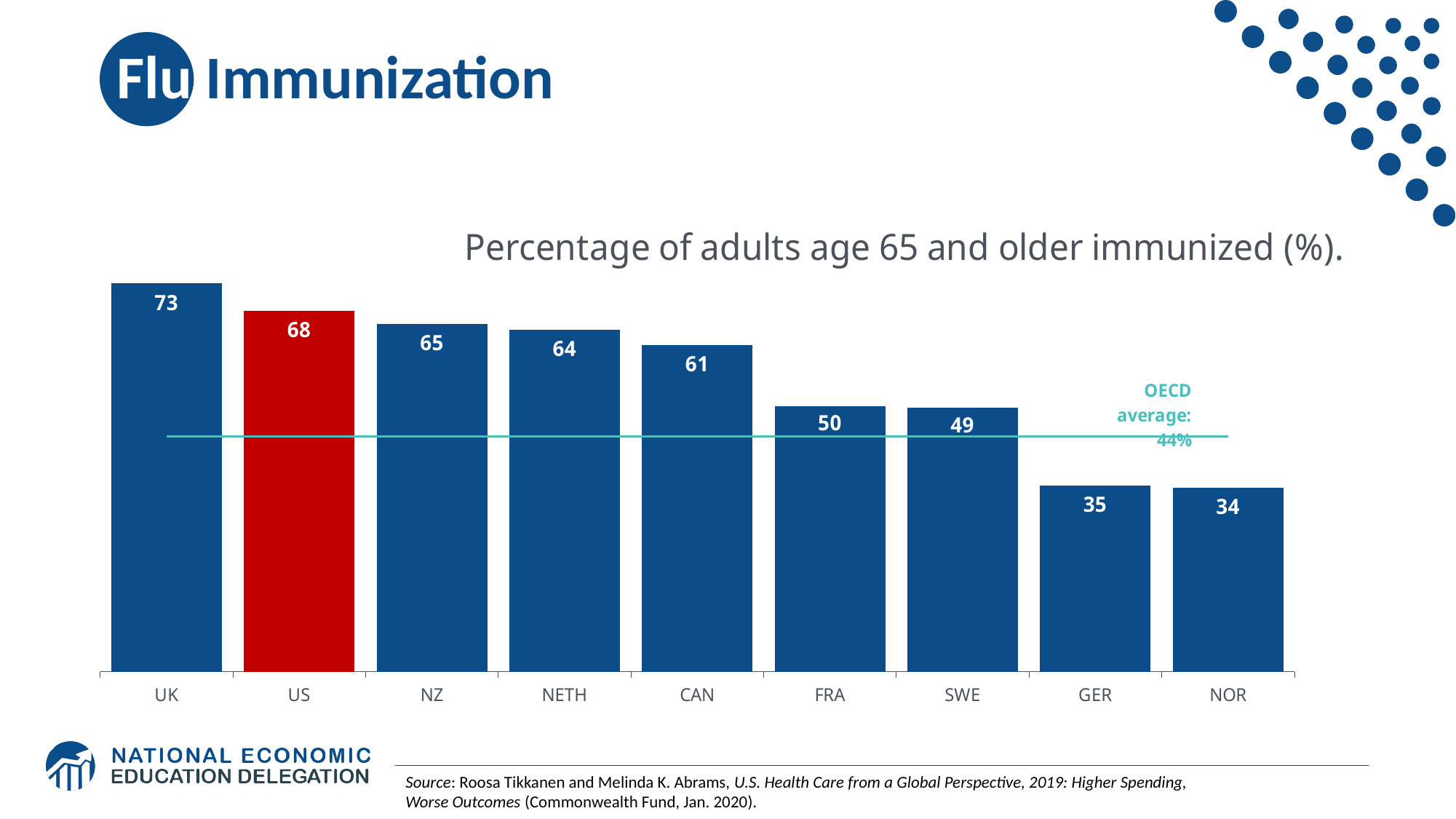
Which country has the highest value? UK How many countries are shown in the chart? 9 What kind of chart is shown on the slide? bar chart What is the difference between the values for CAN and GER? 26 What is the difference between the values for UK and US? 5 Do the values rise or fall from left to right along the x axis? fall What is the value for the US? 68 Which is larger, the value for FRA or the value for SWE? FRA What is the value for NOR? 34 Which country has the lowest value? NOR What is the value for NETH? 64 What OECD average value is marked by the horizontal line on the chart? 44%